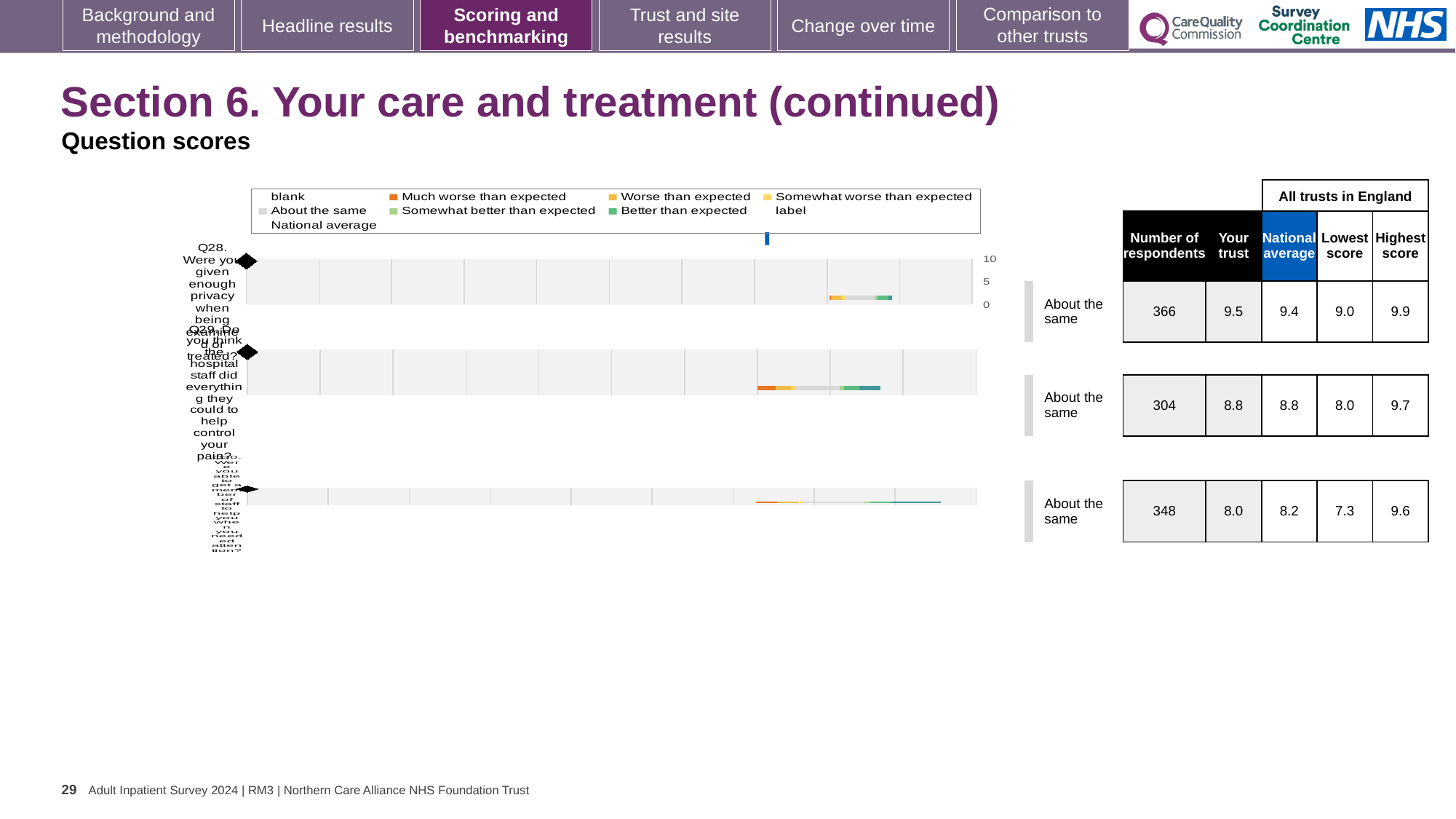
How many questions (categories) are plotted in the chart? 3 Is the 'Your trust' score for Q29 greater or less than 5 on the chart's axis? greater What kind of chart is used to show the question scores on this slide? bar chart What is the difference between the 'Your trust' score and the national average for Q30? 0.2 What is the national average score for Q29 (Do you think the hospital staff did everything they could to help control your pain?)? 8.8 Which of the three questions has the highest 'Your trust' score? Q28 Which of the three questions has the lowest 'Your trust' score? Q30 What is the 'Your trust' score for Q28 (Were you given enough privacy when being examined or treated?)? 9.5 What is the lowest score among all trusts in England for Q30? 7.3 What benchmark category is shown for all three questions on this slide? About the same What is the number of respondents for Q30 (Were you able to get a member of staff to help you when you needed attention?)? 348 What is the highest score among all trusts in England for Q28? 9.9